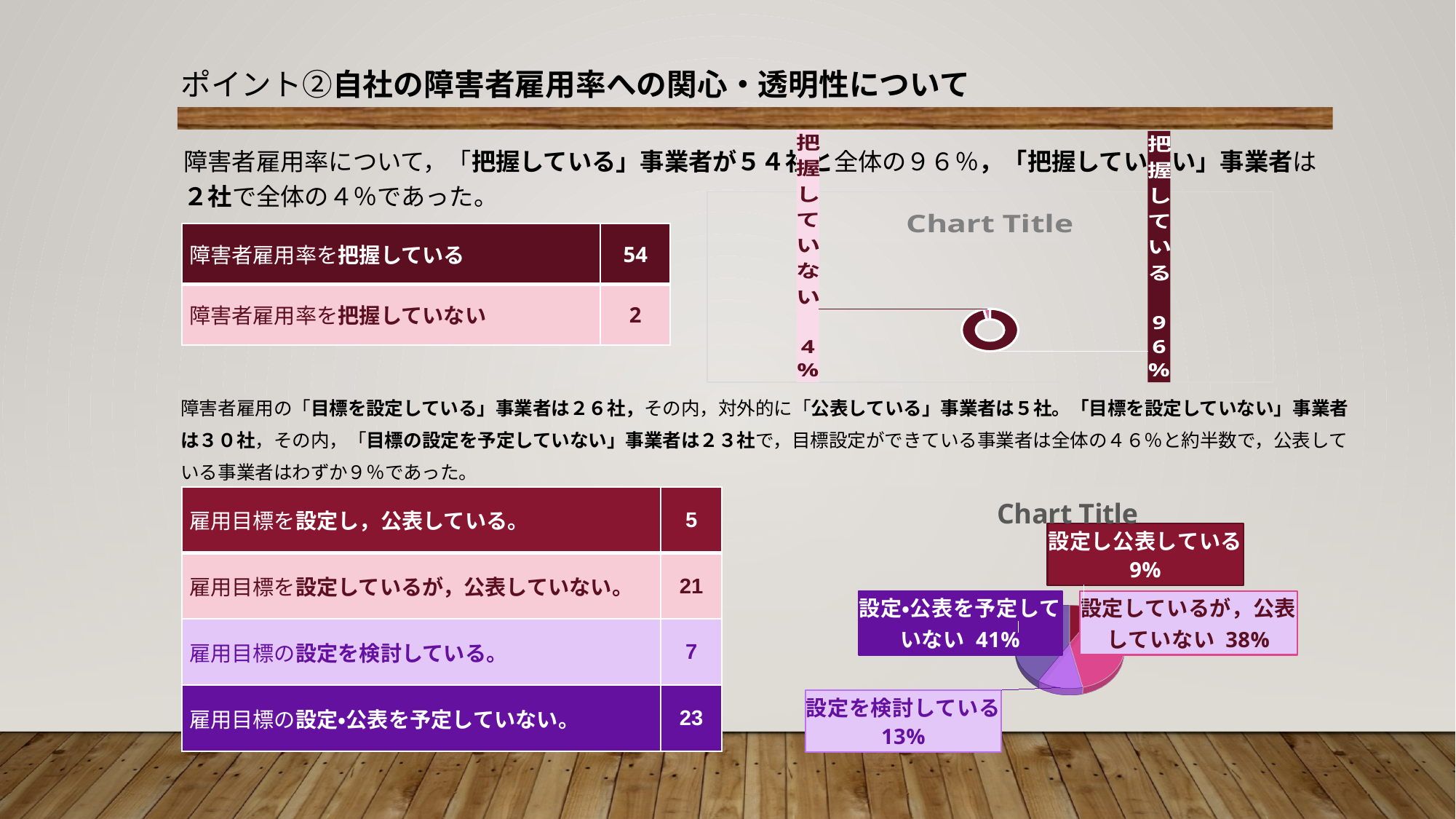
On the pie chart at the bottom right of the slide, what is the difference in percentage points between 設定しているが，公表していない and 設定を検討している? 25 What kind of chart is the chart at the top right of the slide? Doughnut chart On the pie chart at the bottom right of the slide, which slice has the largest share? 設定・公表を予定していない On the pie chart at the bottom right of the slide, what share is labelled for 設定・公表を予定していない? 41% On the doughnut chart at the top right of the slide, which category has the larger share? 把握している On the pie chart at the bottom right of the slide, what share is labelled for 設定を検討している? 13% On the pie chart at the bottom right of the slide, which slice has the smallest share? 設定し公表している On the doughnut chart at the top right of the slide, what share is labelled for 把握している? 96% On the doughnut chart at the top right of the slide, how many categories are shown? 2 On the pie chart at the bottom right of the slide, what share is labelled for 設定しているが，公表していない? 38% On the pie chart at the bottom right of the slide, how many slices are there? 4 On the doughnut chart at the top right of the slide, what share is labelled for 把握していない? 4%